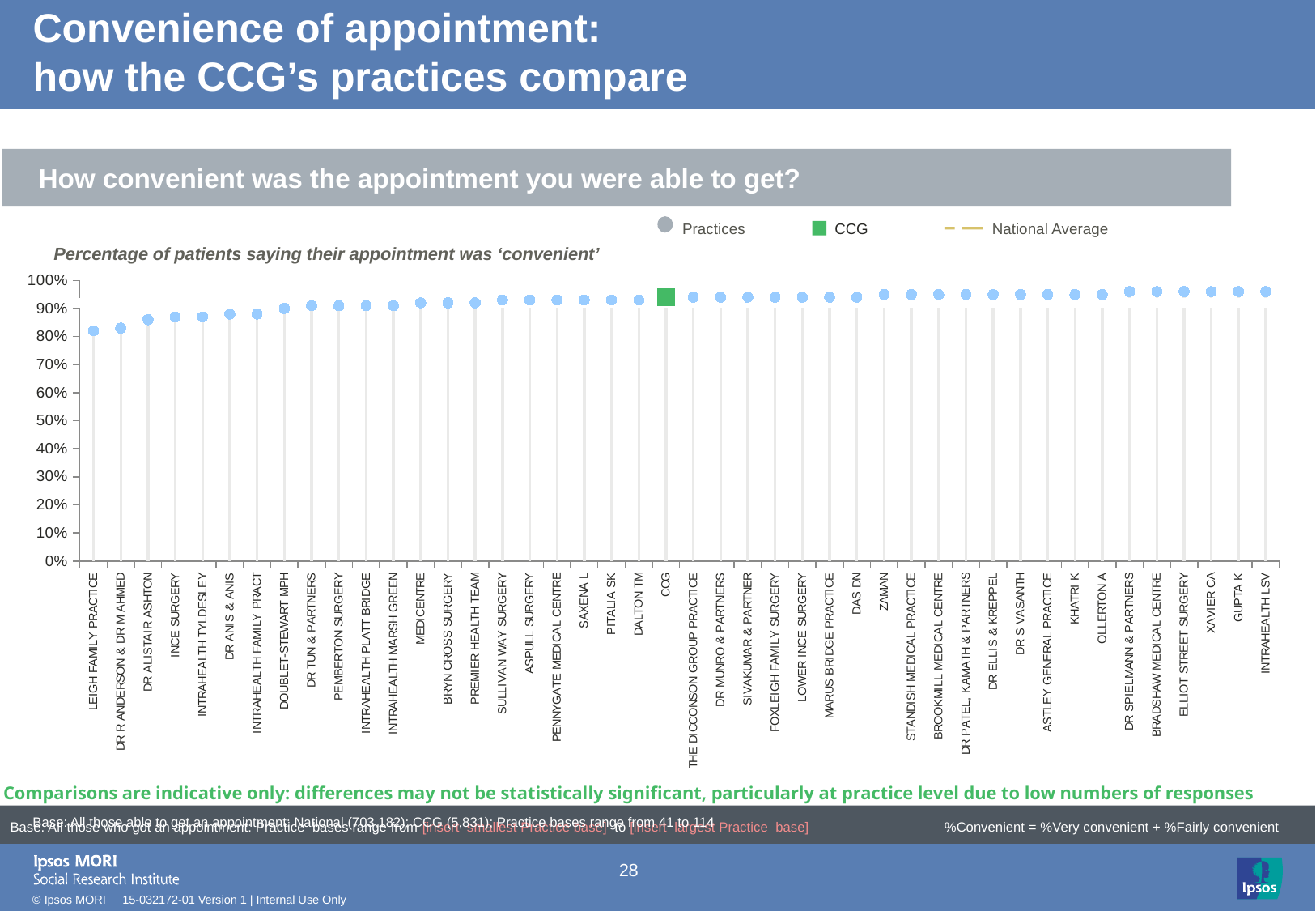
What colour is the marker used for the CCG in the chart? Green What kind of chart is shown on the slide? Dot (scatter) chart Is the value for LEIGH FAMILY PRACTICE greater or less than 90%? less Do the values rise or fall moving from left to right along the x axis? rise What question does the chart's grey header bar say the data is based on? How convenient was the appointment you were able to get? Is the value for INCE SURGERY greater or less than 80%? greater Is the value for INTRAHEALTH LSV greater or less than 90%? greater Which has a higher value, LEIGH FAMILY PRACTICE or INTRAHEALTH LSV? INTRAHEALTH LSV Which practice has the lowest percentage of patients saying their appointment was 'convenient'? LEIGH FAMILY PRACTICE How many entries does the chart legend list? 3